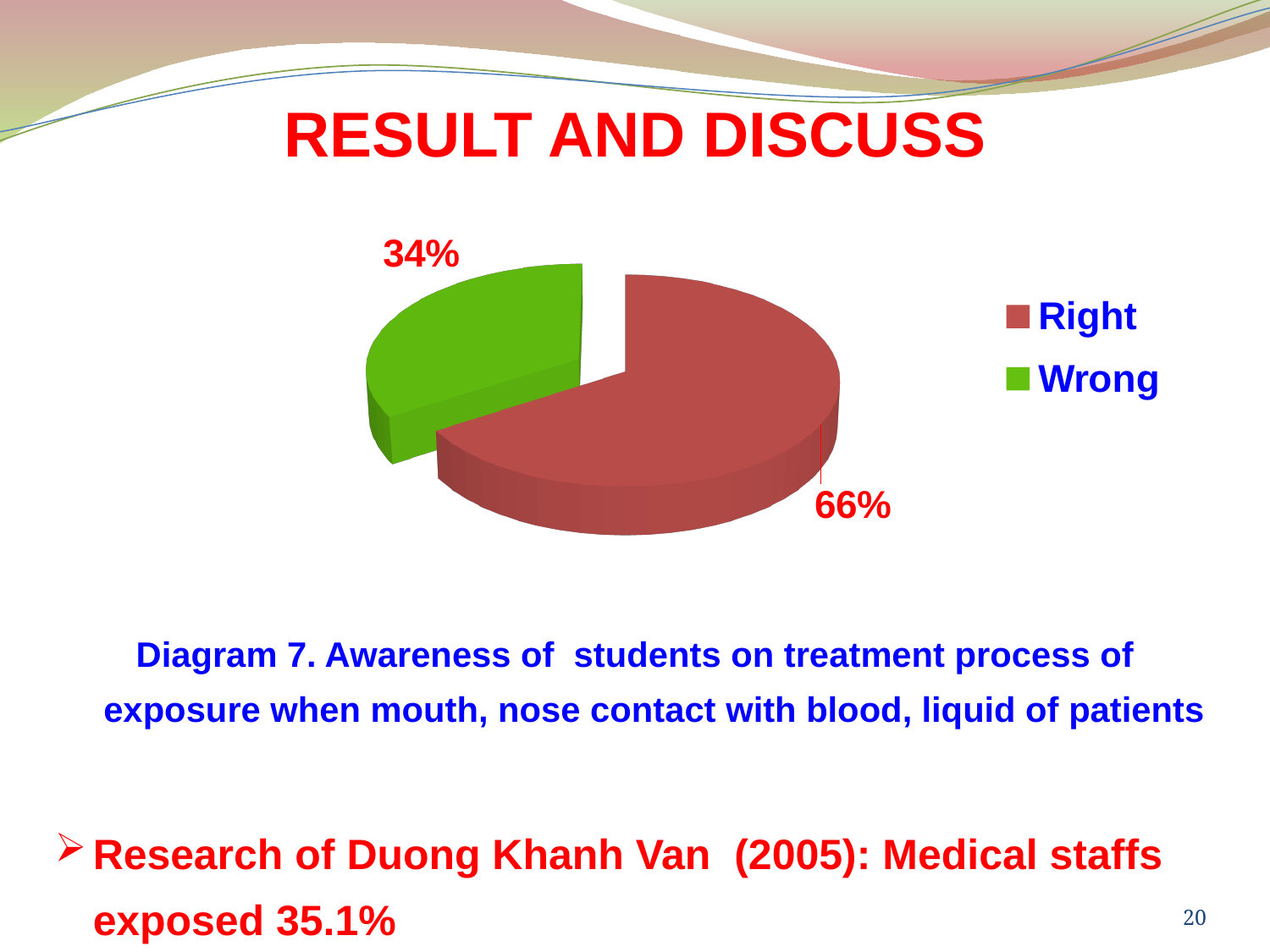
How many slices does the pie chart have? 2 What kind of chart is shown on the slide? Pie chart What share of the pie is labelled "Wrong"? 34% How many entries does the legend list? 2 What is the total of the two slice percentages shown on the pie chart? 100% What colour is the "Right" slice in the pie chart? Red Which is larger, the "Right" slice or the "Wrong" slice? Right What is the difference in percentage points between the "Right" and "Wrong" slices? 32 What share of the pie is labelled "Right"? 66% Which slice of the pie is the largest? Right Which slice of the pie is the smallest? Wrong What colour is the "Wrong" slice in the pie chart? Green